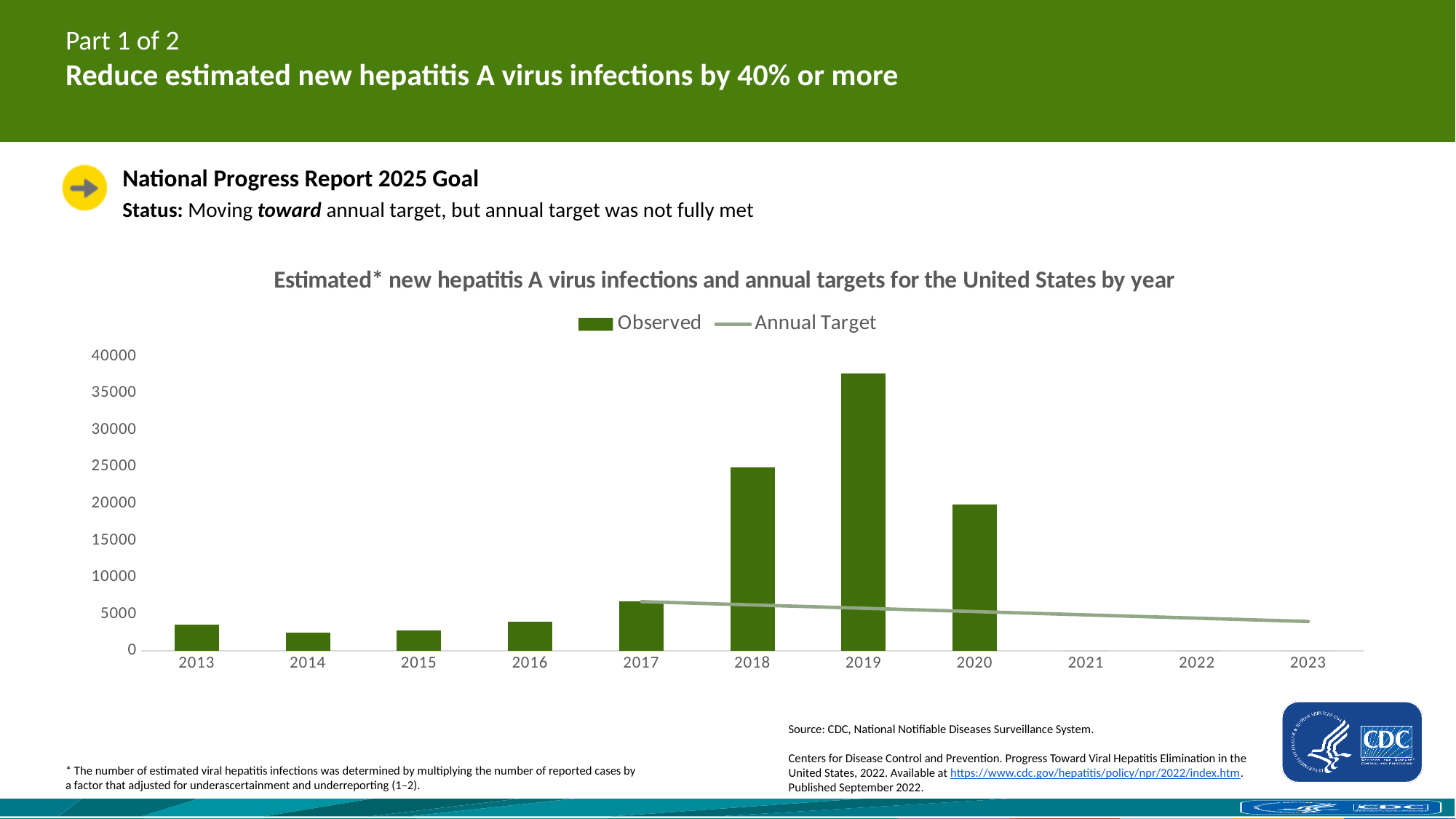
How many years are shown on the x axis? 11 Which year has the highest Observed value? 2019 What kind of chart is used to show the Observed series? bar chart What are the two entries in the chart legend? Observed and Annual Target Is the Observed value for 2017 greater or less than 5000? greater Is the Observed value for 2019 greater or less than 35000? greater How many series does the legend list? 2 Is the Observed value for 2018 greater or less than 20000? greater Which is larger, the Observed value for 2018 or for 2020? 2018 Does the Annual Target line rise or fall from 2017 to 2023? fall